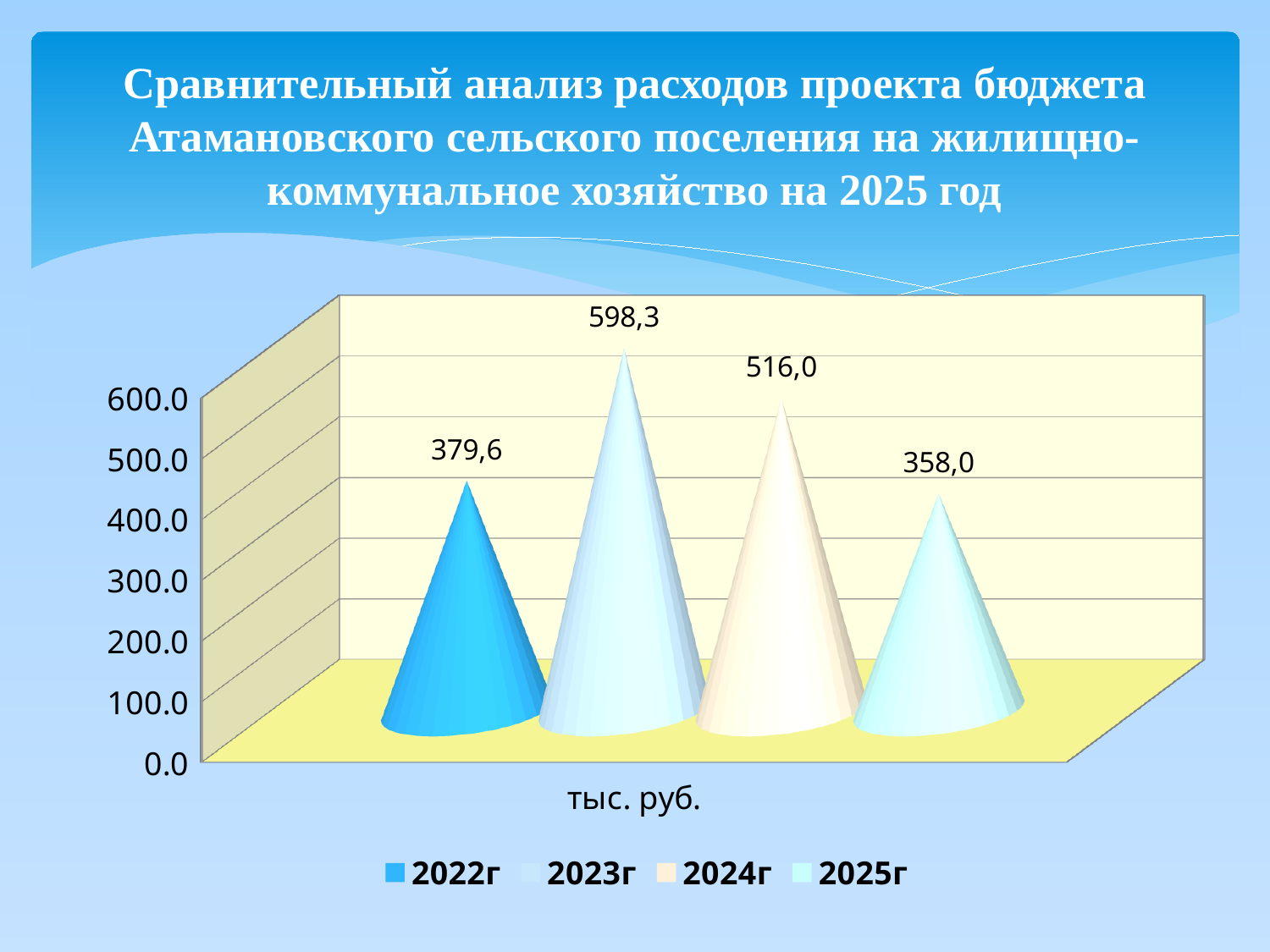
What is the difference between the values for 2023г and 2022г? 218,7 What is the value for 2025г? 358,0 What is the difference between the values for 2024г and 2025г? 158,0 Which is larger, the value for 2024г or the value for 2022г? 2024г What is the value for 2023г? 598,3 What unit label is shown under the chart's category axis? тыс. руб. What is the value for 2024г? 516,0 What is the value for 2022г? 379,6 How many series does the legend list? 4 Which year has the lowest value? 2025г What kind of chart is shown on the slide? bar chart Which year has the highest value? 2023г